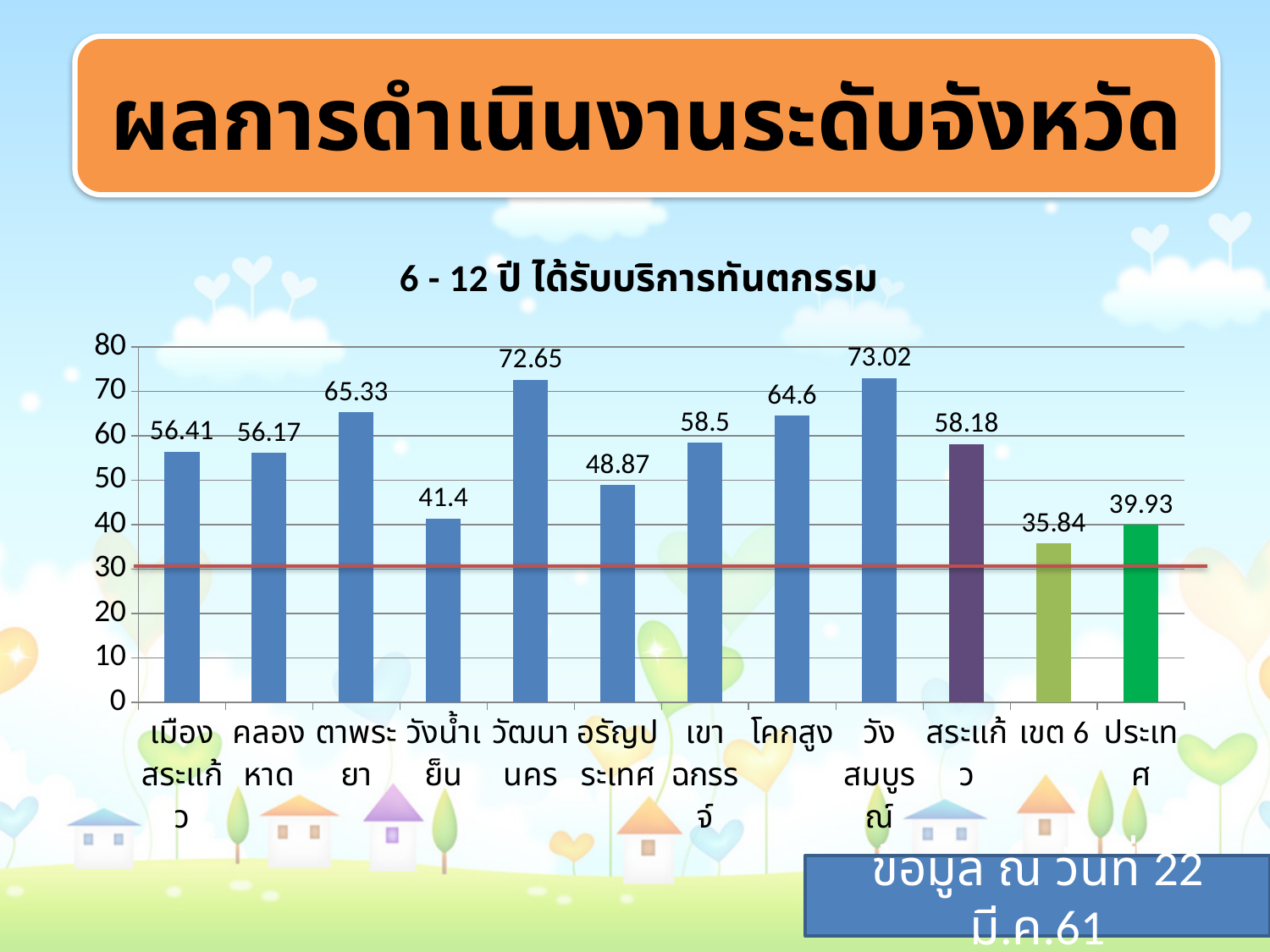
How many categories are plotted on the chart? 12 What is the value for ประเทศ? 39.93 Is the value for อรัญประเทศ greater or less than 50? less What is the value for เขต 6? 35.84 What is the chart's title? 6 - 12 ปี ได้รับบริการทันตกรรม What is the value for วังสมบูรณ์? 73.02 Which category has the lowest value? เขต 6 What type of chart is shown on the slide? bar chart Which is larger, the value for ตาพระยา or the value for โคกสูง? ตาพระยา What is the difference between the values for วัฒนานคร and วังน้ำเย็น? 31.25 Which category has the highest value? วังสมบูรณ์ What is the value for สระแก้ว? 58.18